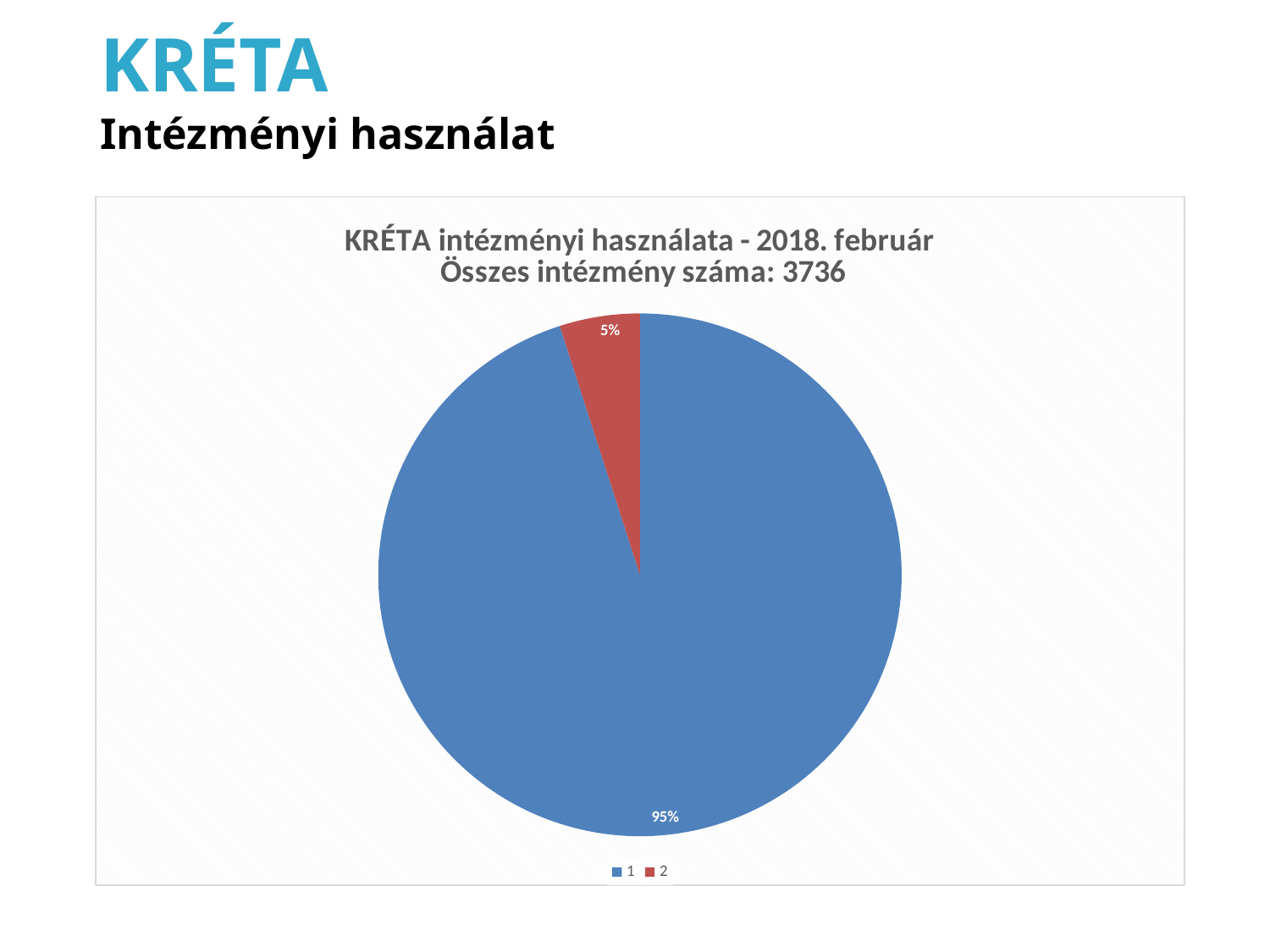
What is the difference in percentage points between the slice for category 1 and the slice for category 2? 90 How many slices does the pie chart have? 2 Which category has the smallest slice of the pie? 2 Which is larger, the slice for category 1 or the slice for category 2? 1 What colour is the slice for category 2? red Which category has the largest slice of the pie? 1 How many entries does the legend list? 2 What is the title of the chart? KRÉTA intézményi használata - 2018. február Összes intézmény száma: 3736 What share of the pie does category 2 represent? 5% What kind of chart is shown on the slide? pie chart What share of the pie does category 1 represent? 95%